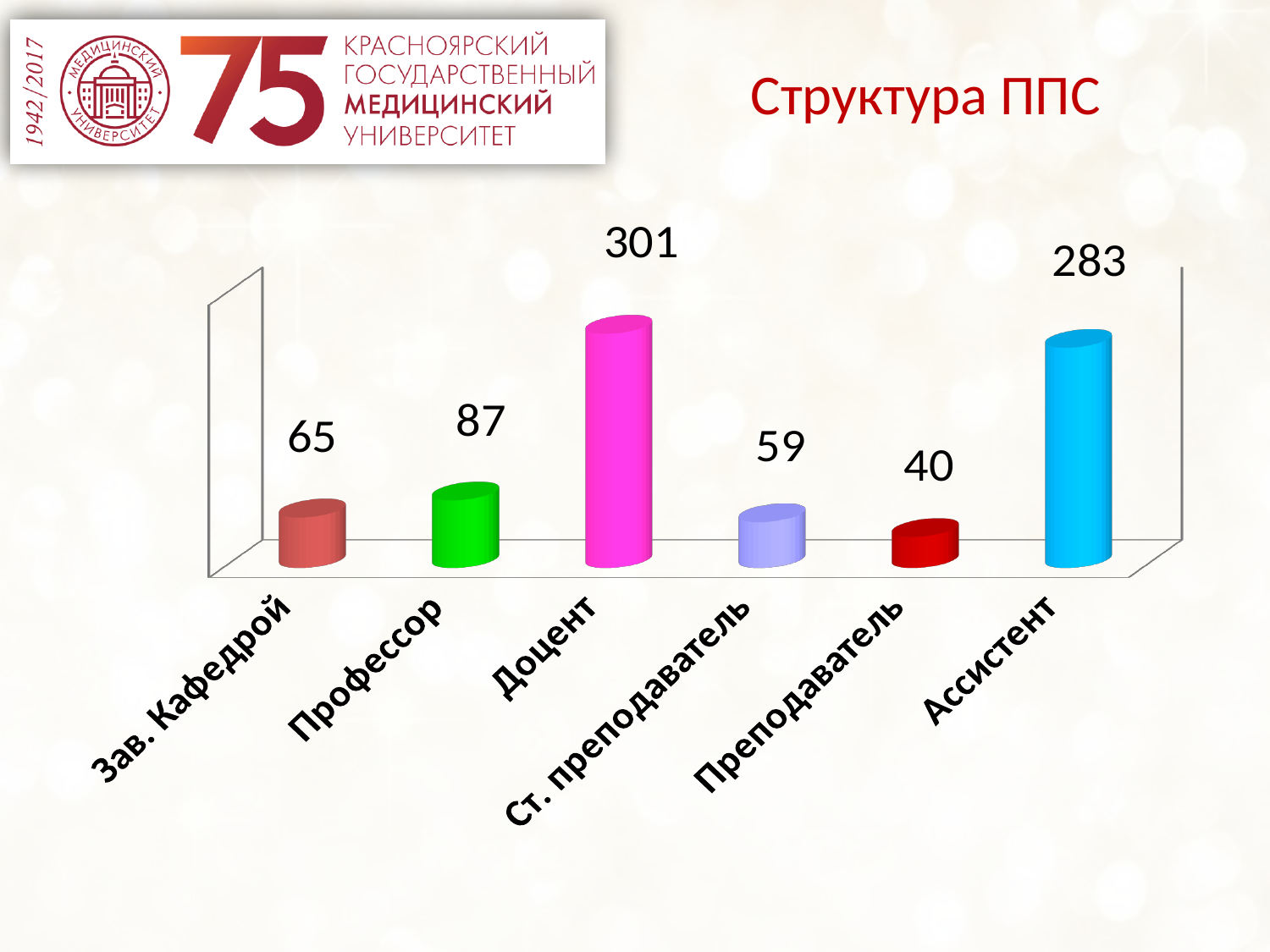
What is the value for Зав. Кафедрой? 65 What is the difference between the values for Доцент and Ассистент? 18 What is the value for Ассистент? 283 What is the value for Доцент? 301 Which is larger, the value for Профессор or the value for Зав. Кафедрой? Профессор Which category has the lowest value? Преподаватель How many categories are shown in the chart? 6 What is the difference between the values for Профессор and Ст. преподаватель? 28 What is the value for Преподаватель? 40 What is the title of the chart? Структура ППС What kind of chart is shown on the slide? Bar chart Which category has the highest value? Доцент